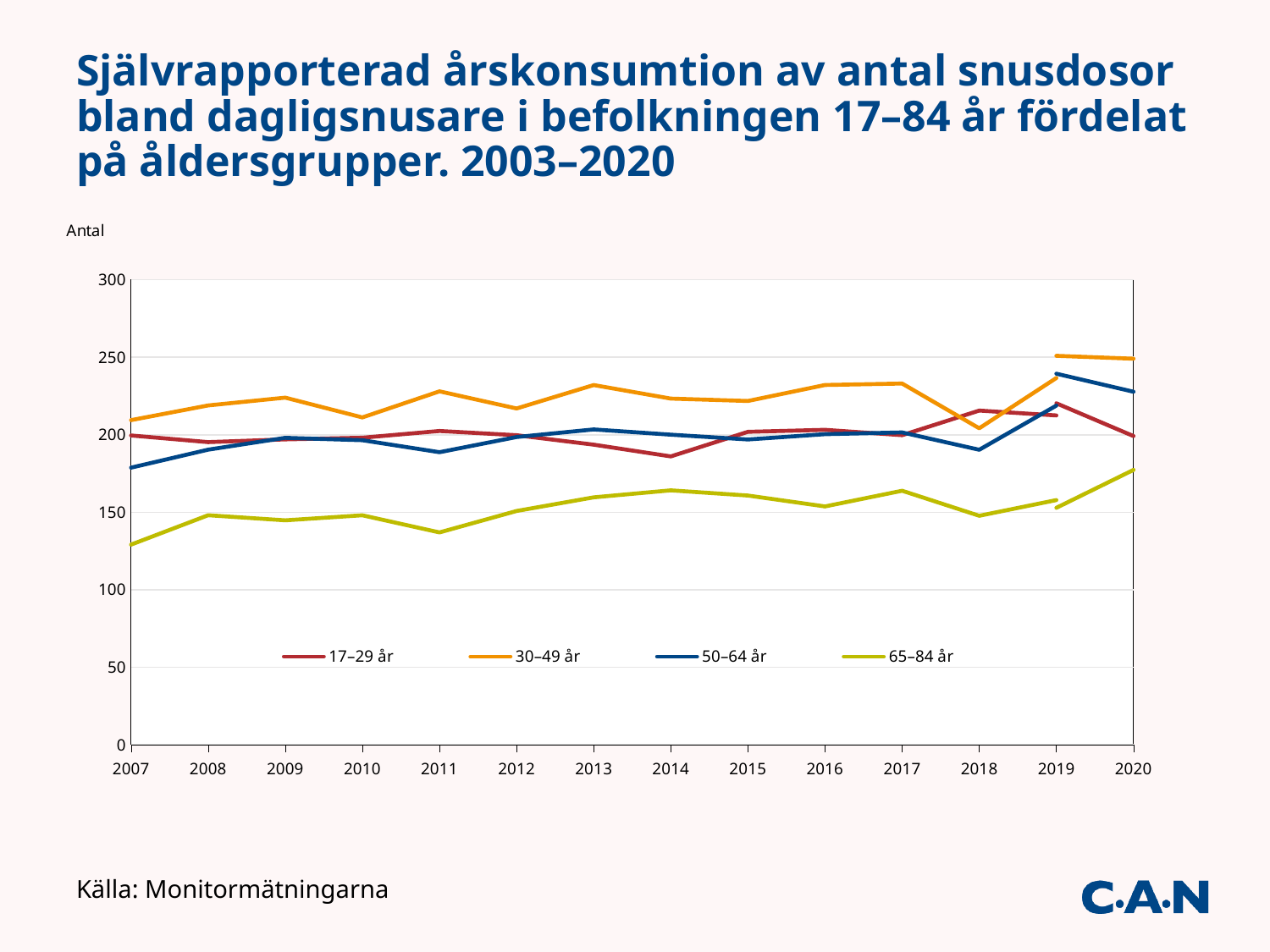
Which age group has the highest value in 2020? 30–49 år How many years are plotted along the x axis? 14 In 2019, which is larger: the value for 50–64 år or the value for 17–29 år? 50–64 år What kind of chart is shown on the slide? Line chart Is the value for 65–84 år in 2007 greater or less than 150? less Which age group has the highest value in 2013? 30–49 år Does the value for 65–84 år rise or fall from 2018 to 2020? rise What label is shown on the vertical axis? Antal How many series does the legend list? 4 Is the value for 50–64 år in 2007 greater or less than 200? less Is the value for 30–49 år in 2013 greater or less than 200? greater Which age group has the lowest value in 2007? 65–84 år